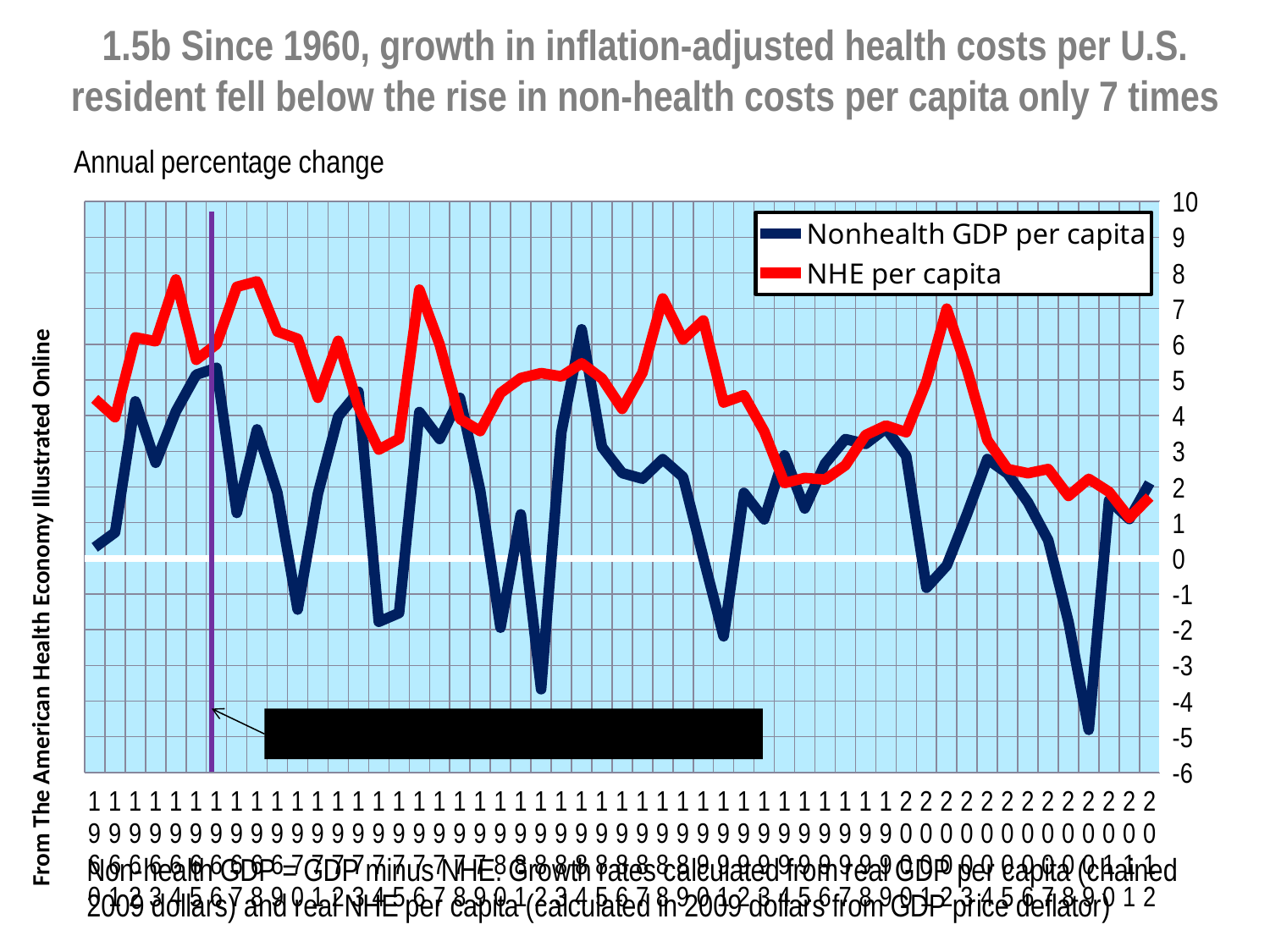
What are the two series named in the legend? Nonhealth GDP per capita and NHE per capita Which series is drawn in red? NHE per capita At the leftmost point of the chart, which series has the higher value? NHE per capita Is the lowest value of the Nonhealth GDP per capita line greater or less than -4? less Does the Nonhealth GDP per capita line ever fall below 0? Yes Does the NHE per capita line ever fall below 0? No Which series reaches the highest value anywhere on the chart? NHE per capita Which series reaches the lowest value anywhere on the chart? Nonhealth GDP per capita What kind of chart is shown on the slide? Line chart What is the highest value shown on the vertical axis? 10 How many series does the legend list? 2